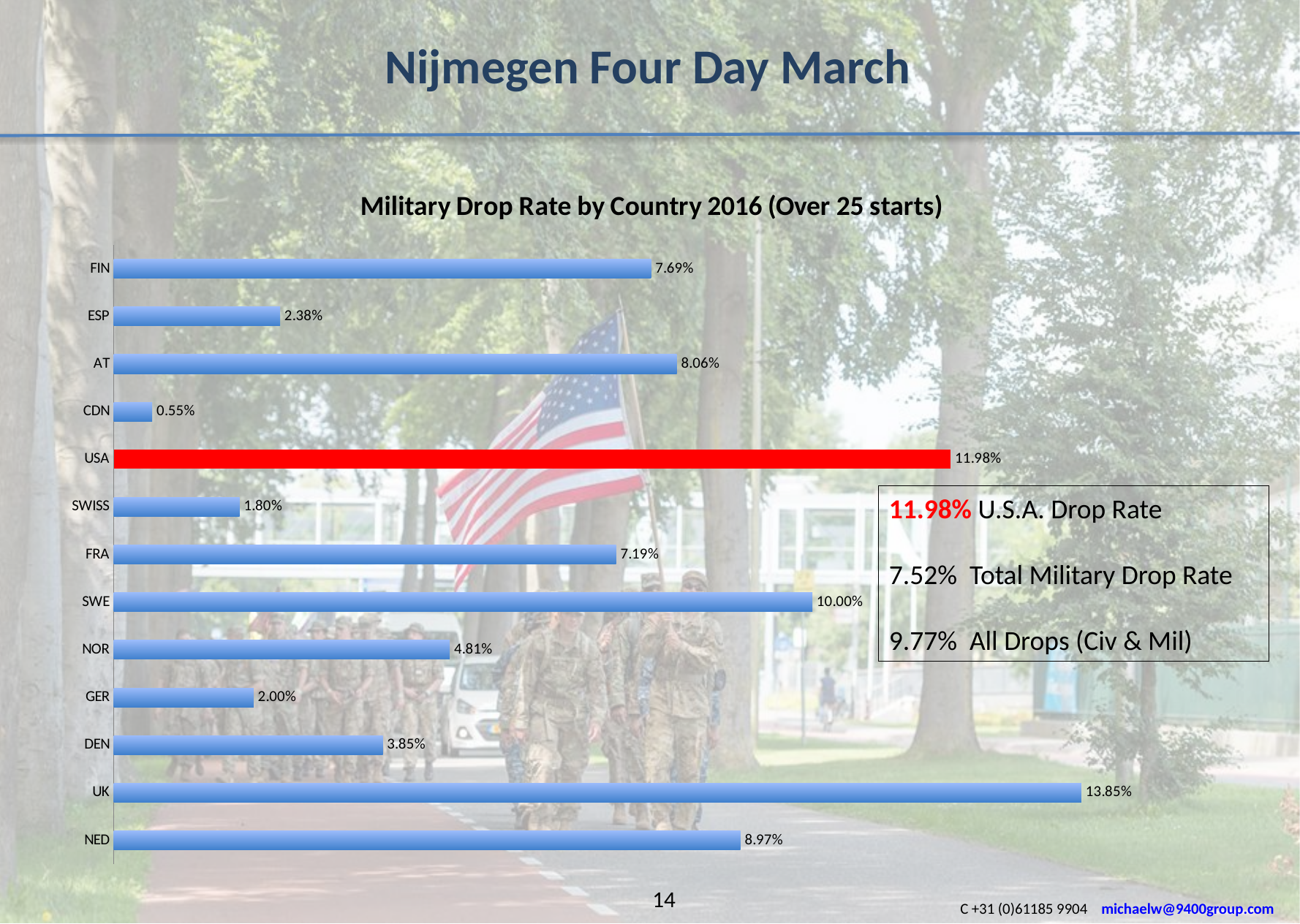
Which has a higher military drop rate, DEN or GER? DEN What type of chart is shown on the slide? Bar chart What is the military drop rate for the USA? 11.98% What is the difference between the UK and USA military drop rates? 1.87 percentage points What is the military drop rate for NED? 8.97% What is the military drop rate for SWE? 10.00% What is the difference between the SWE and FRA military drop rates? 2.81 percentage points What is the military drop rate for CDN? 0.55% Which has a higher military drop rate, AT or FIN? AT How many countries are shown in the chart? 13 Which country has the lowest military drop rate? CDN Which country has the highest military drop rate? UK